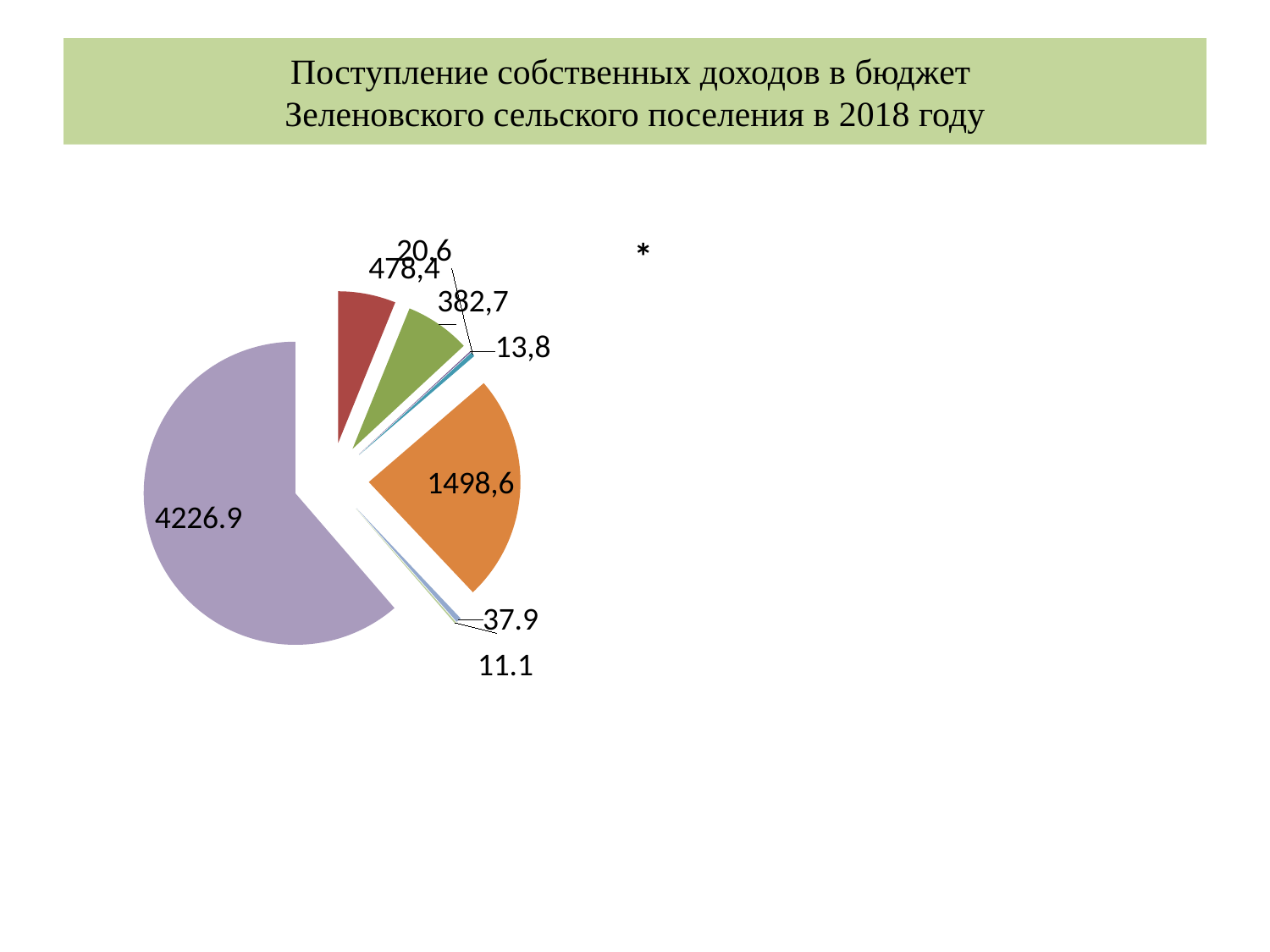
What is the value shown on the red slice of the pie chart? 478,4 What is the smallest value labelled on the pie chart? 11.1 How many slices does the pie chart have? 8 What is the difference between the red slice (478,4) and the green slice (382,7)? 95,7 Which slice is larger, the purple one (4226.9) or the orange one (1498,6)? purple (4226.9) What is the value shown on the green slice of the pie chart? 382,7 Does the pie chart include a legend identifying the slices? No What is the value shown on the orange slice of the pie chart? 1498,6 What kind of chart is shown on the slide? pie chart Which value labels the largest slice of the pie chart? 4226.9 What is the value shown on the largest (purple) slice of the pie chart? 4226.9 What is the title of the slide containing the pie chart? Поступление собственных доходов в бюджет Зеленовского сельского поселения в 2018 году